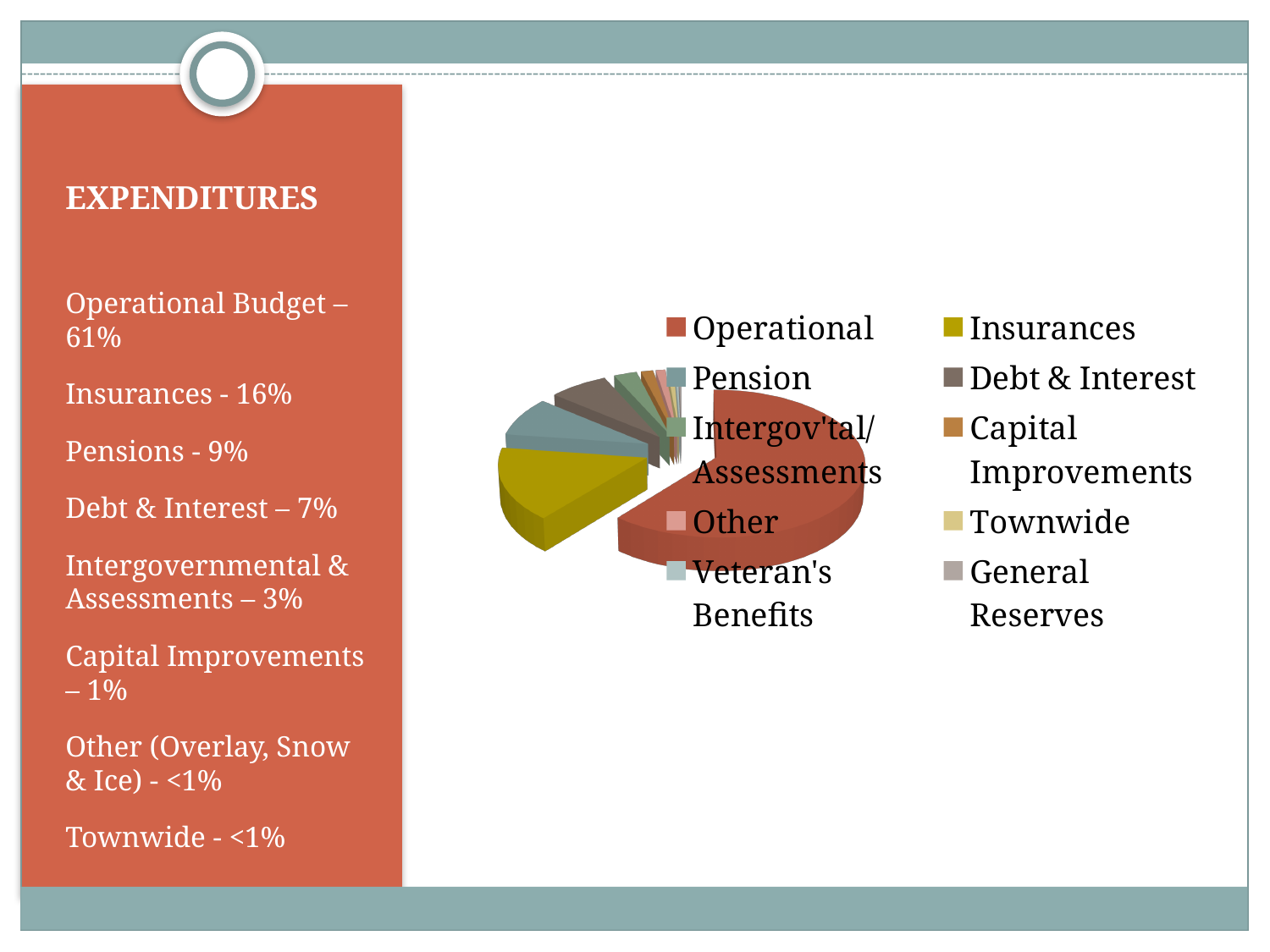
According to the slide, what percentage of expenditures is Pensions? 9% By how many percentage points does the Operational Budget share exceed the Insurances share? 45 What kind of chart is shown on the slide? pie chart How many categories does the pie chart's legend list? 10 According to the slide, what percentage of expenditures is Debt & Interest? 7% Which legend entry is shown in olive/yellow in the pie chart? Insurances Which slice is larger in the pie chart, Operational or Insurances? Operational Which category has the largest slice of the pie chart? Operational According to the slide, what share of expenditures goes to Insurances? 16% According to the slide, what share of expenditures is the Operational Budget? 61% What colour is the Operational slice in the pie chart? red Which slice is larger in the pie chart, Insurances or Pension? Insurances